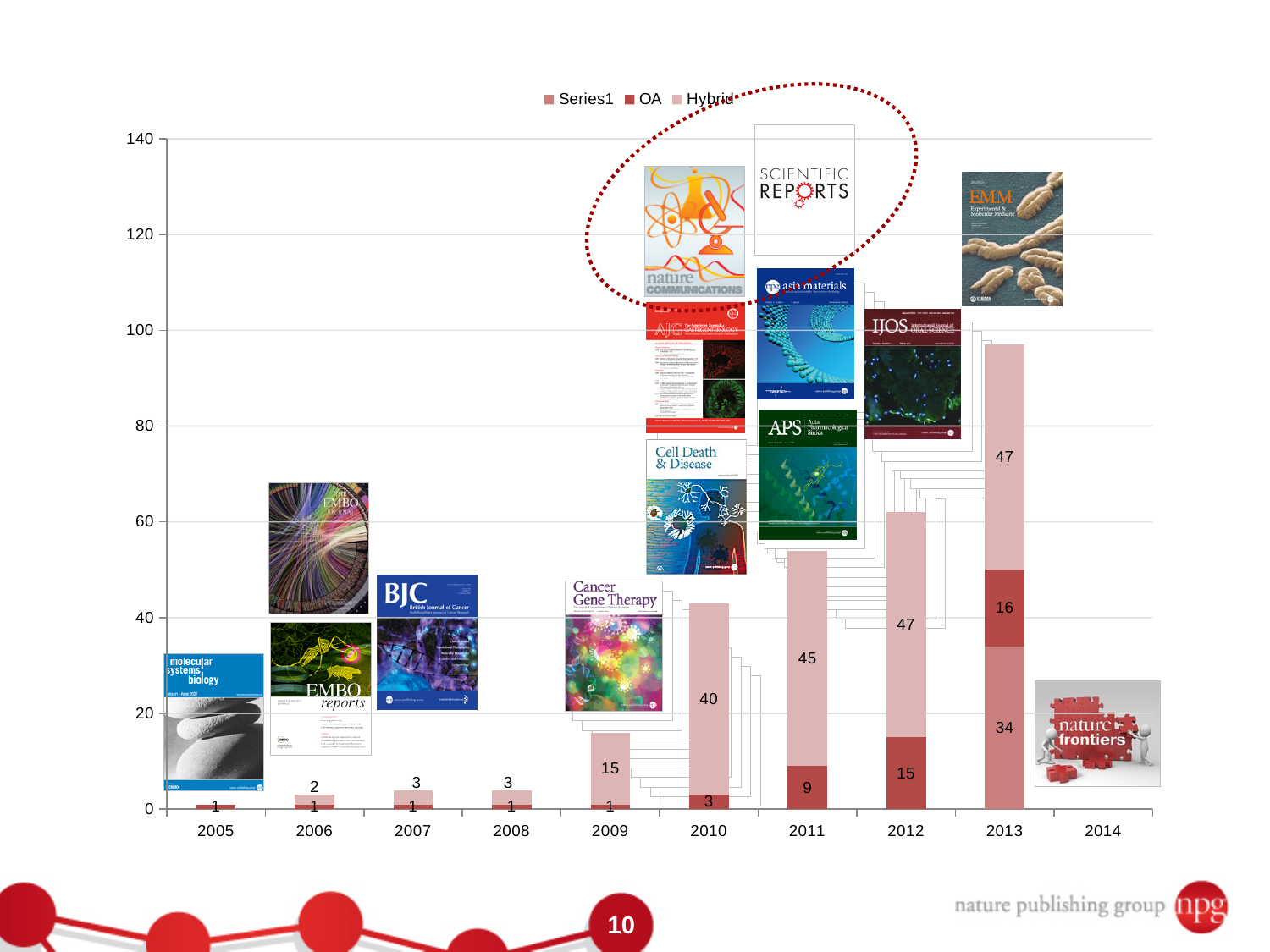
Which year has the tallest stacked bar? 2013 What is the OA value for 2012? 15 What is the total of the stacked bar for 2013? 97 What kind of chart is shown on the slide? bar chart Which is larger, the Hybrid value for 2009 or the OA value for 2011? Hybrid value for 2009 What is the total of the stacked bar for 2012? 62 What is the Hybrid value for 2010? 40 How many years are shown on the x axis? 10 How many series does the legend list? 3 What is the difference between the Hybrid value for 2011 and the Hybrid value for 2010? 5 What is the OA value for 2011? 9 What are the three entries in the chart legend? Series1, OA, Hybrid